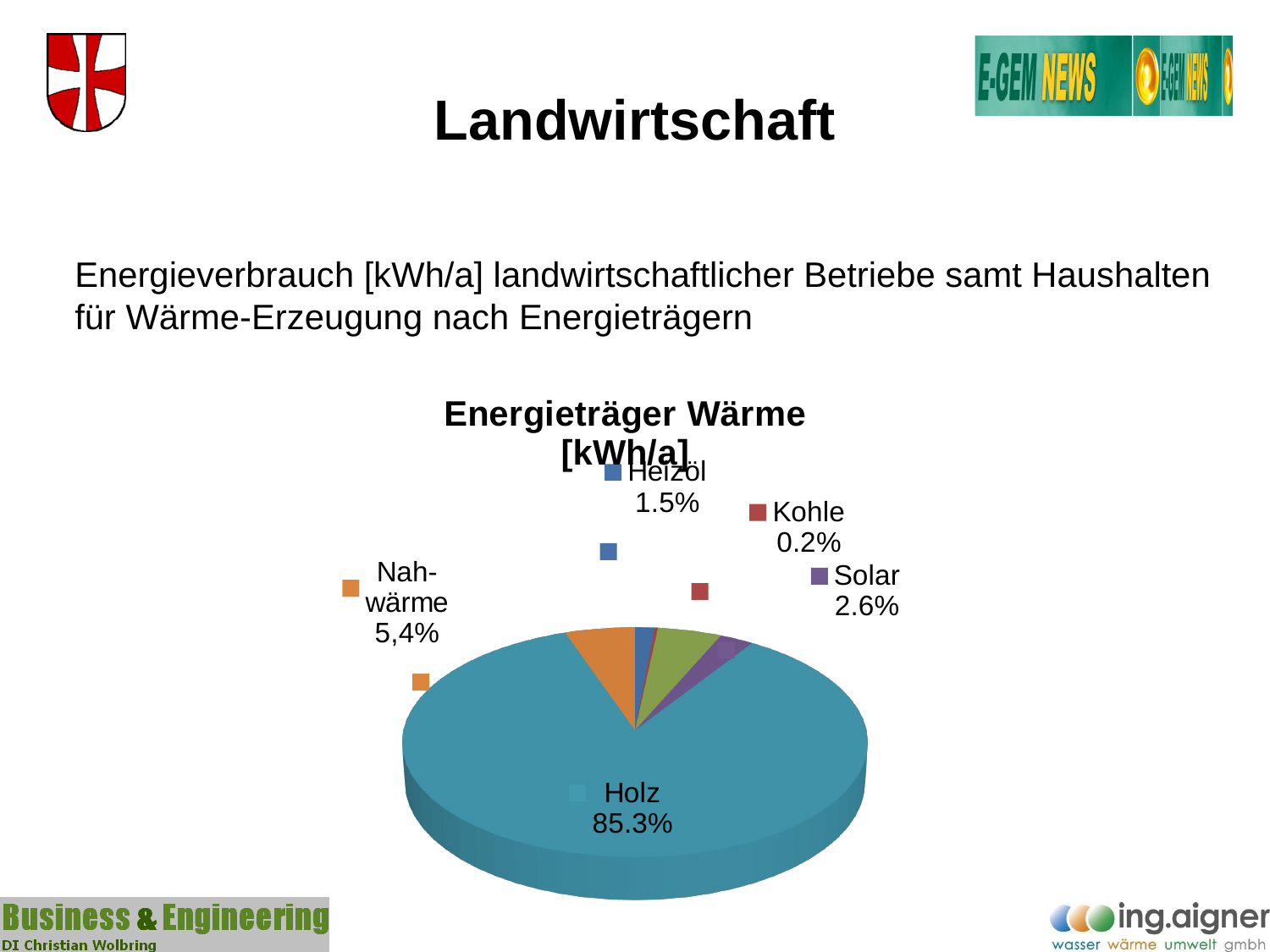
What is the title of the chart? Energieträger Wärme [kWh/a] Which labelled energy source has the smallest share of the pie? Kohle What is the value shown for Heizöl? 1.5% What is the value shown for Kohle? 0.2% Which energy source has the largest share of the pie? Holz What share of the pie does Holz account for? 85.3% What is the value shown for Solar? 2.6% Which has a larger share, Solar or Heizöl? Solar What kind of chart is shown on the slide? pie chart What is the difference in percentage points between Holz and Nahwärme? 79.9 What is the difference in percentage points between Solar and Heizöl? 1.1 What is the value shown for Nahwärme? 5,4%